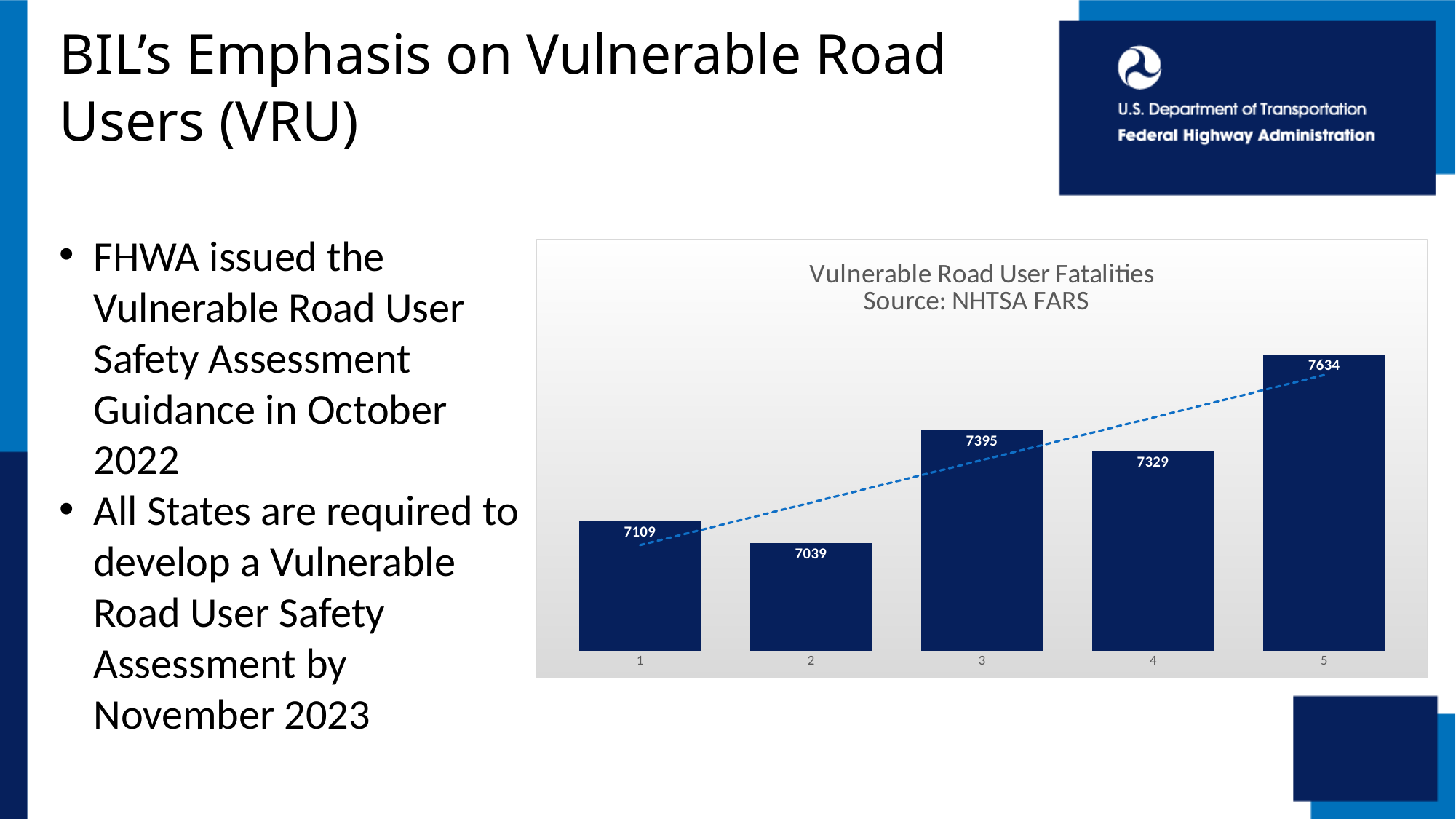
What is the value for category 5? 7634 What kind of chart is shown? Bar chart What is the difference between the values for category 5 and category 1? 525 Which is larger, the value for category 3 or category 4? Category 3 What is the value for category 1? 7109 How many bars are in the chart? 5 Which category has the lowest value? 2 Which category has the highest value? 5 What is the value for category 2? 7039 What is the title of the chart? Vulnerable Road User Fatalities Source: NHTSA FARS What is the value for category 4? 7329 What is the value for category 3? 7395